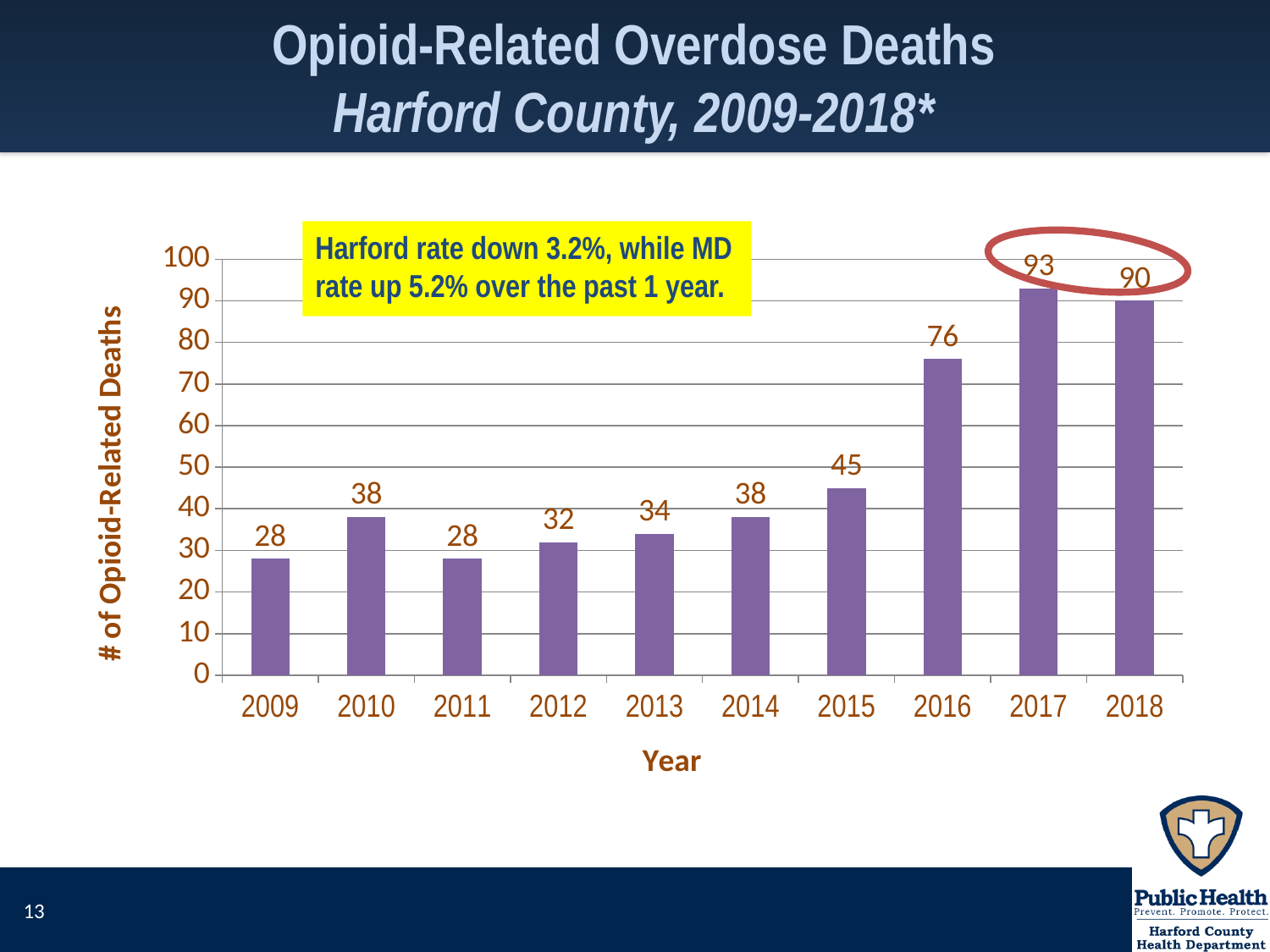
How many years are shown on the x axis? 10 Which year has the highest number of opioid-related deaths? 2017 What is the number of opioid-related deaths in 2016? 76 What is the label of the y axis? # of Opioid-Related Deaths What is the number of opioid-related deaths in 2013? 34 Do the values generally rise or fall from 2013 to 2017? rise Which is larger, the value for 2012 or the value for 2014? 2014 What is the difference between the values for 2016 and 2015? 31 What kind of chart is shown on the slide? bar chart What is the difference between the values for 2017 and 2018? 3 Is the value for 2015 greater or less than 40? greater What is the lowest value shown on the chart? 28